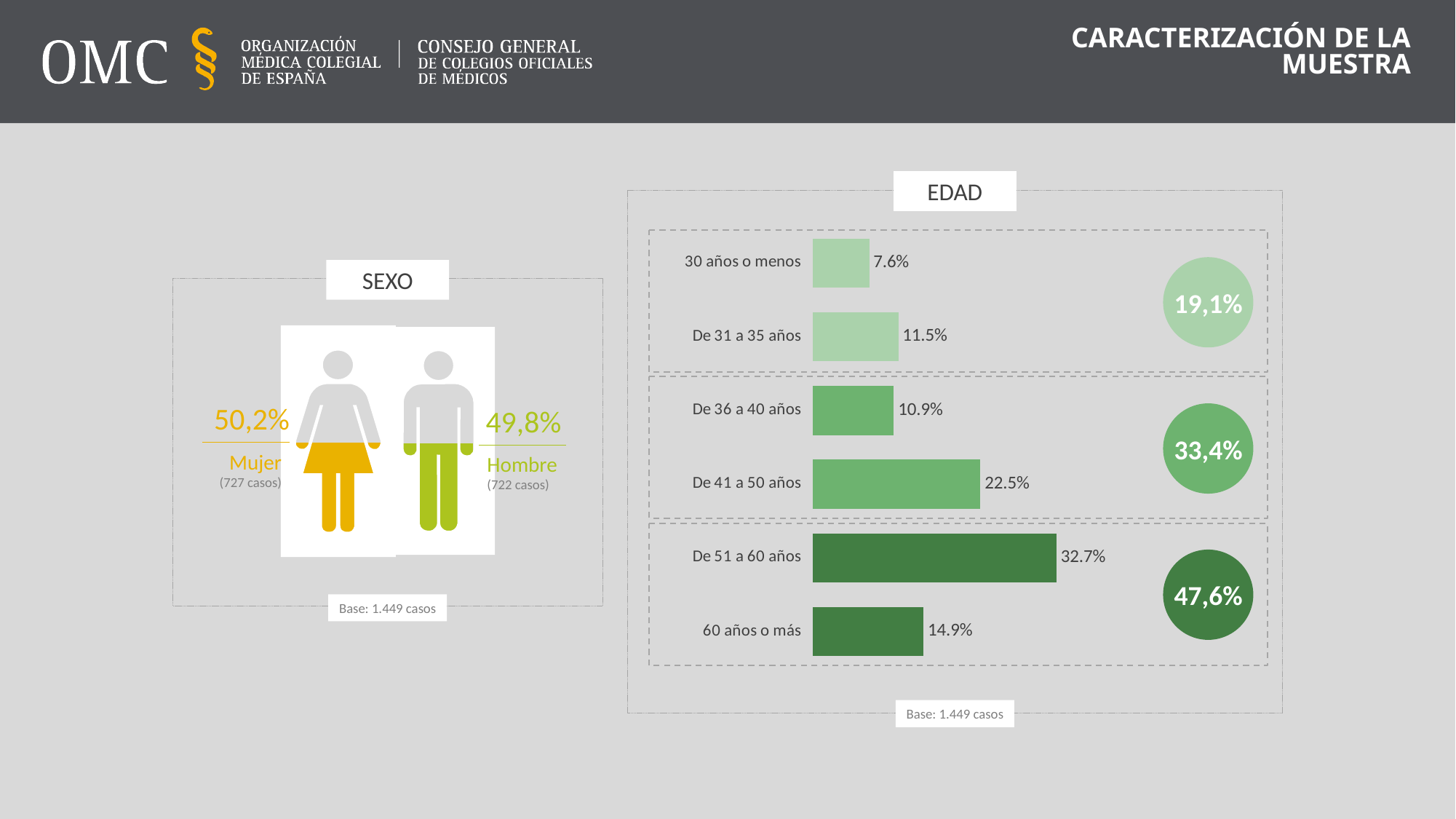
In the EDAD chart, which age group has the highest percentage? De 51 a 60 años In the EDAD chart, what percentage is shown for '30 años o menos'? 7.6% In the EDAD chart, which age group has the lowest percentage? 30 años o menos In the EDAD chart, what percentage is shown for 'De 41 a 50 años'? 22.5% In the EDAD chart, which is larger: 'De 36 a 40 años' or '60 años o más'? 60 años o más In the EDAD chart, what combined percentage is shown in the circle for the two youngest age groups? 19,1% In the SEXO chart, what percentage is shown for Mujer? 50,2% How many age categories are shown in the EDAD chart? 6 In the SEXO chart, how many cases are shown for Hombre? 722 casos What kind of chart is the EDAD chart? Bar chart In the EDAD chart, what percentage is shown for 'De 51 a 60 años'? 32.7% In the EDAD chart, what is the difference in percentage points between 'De 51 a 60 años' and 'De 41 a 50 años'? 10.2